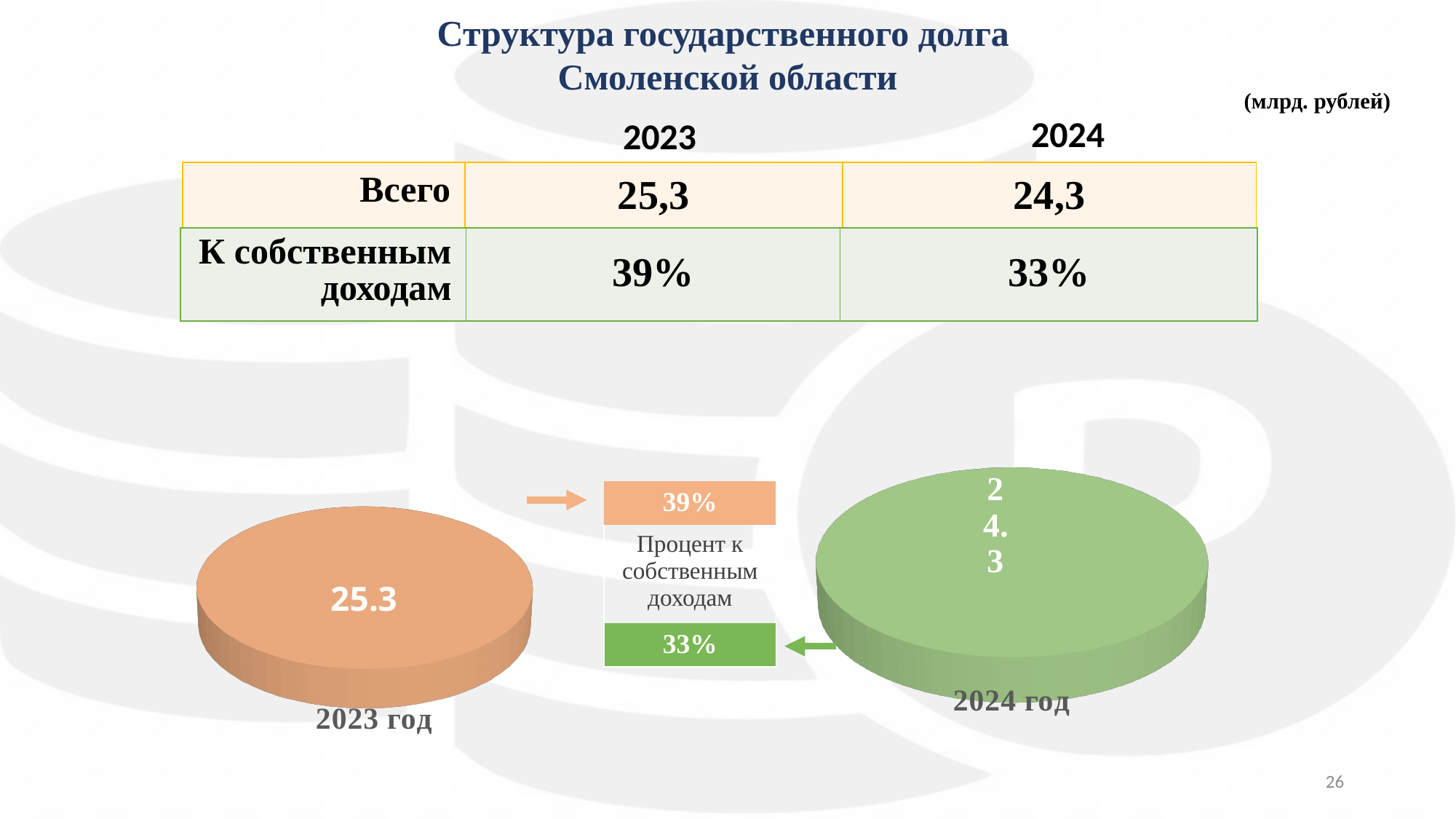
In the pie chart labelled "2024 год", what value is printed on the pie? 24.3 Which pie chart shows the larger value, the one labelled "2023 год" or the one labelled "2024 год"? 2023 год How many slices does the pie chart labelled "2023 год" have? 1 What colour is the pie chart labelled "2023 год"? orange What kind of chart is the one labelled "2023 год"? pie chart How many slices does the pie chart labelled "2024 год" have? 1 What kind of chart is the one labelled "2024 год"? pie chart What colour is the pie chart labelled "2024 год"? green In the pie chart labelled "2023 год", what value is printed on the pie? 25.3 How many pie charts are shown on the slide? 2 Does the value shown on the pie charts rise or fall from 2023 to 2024? fall What is the difference between the value on the "2023 год" pie chart and the value on the "2024 год" pie chart? 1.0